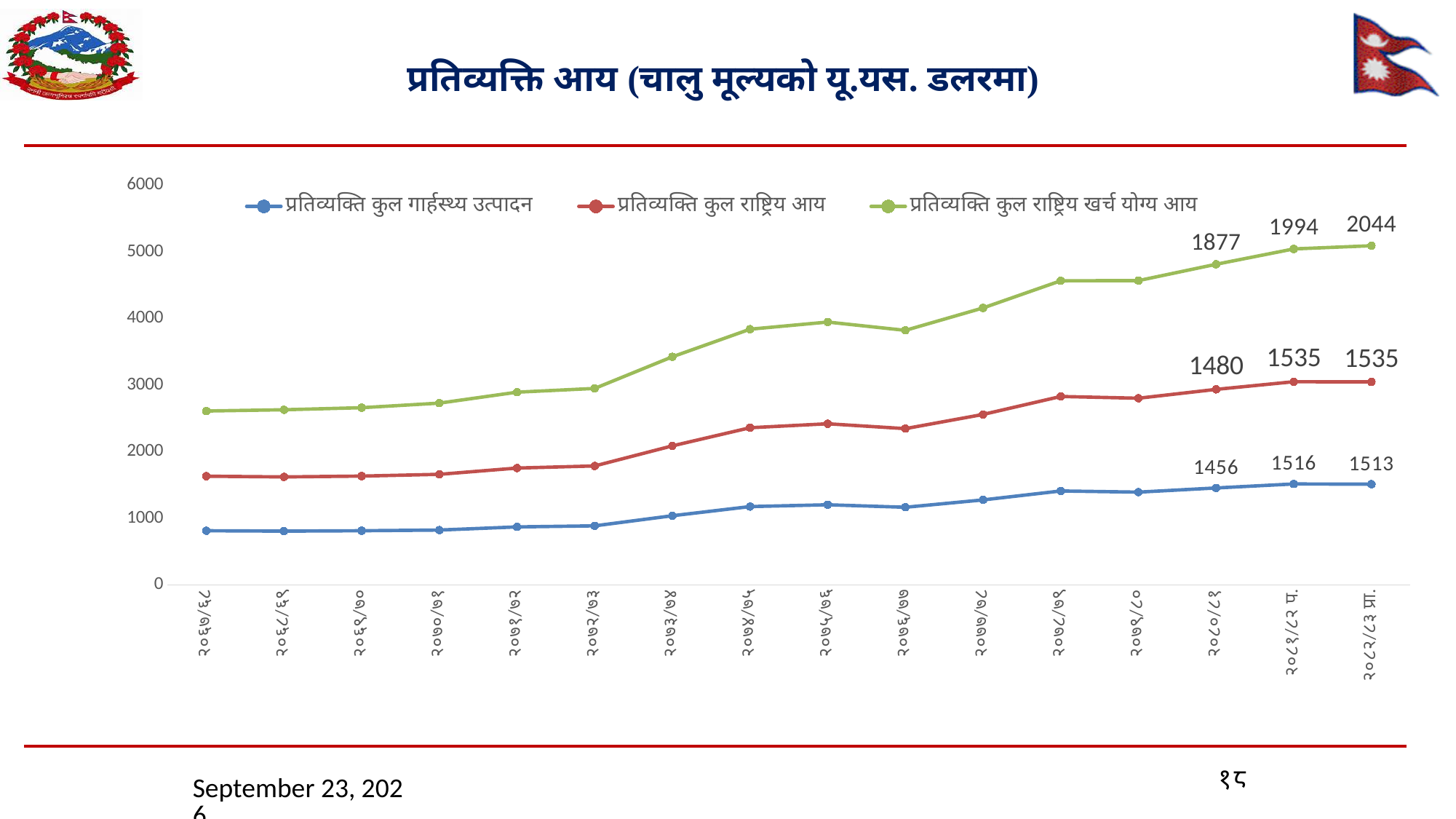
How many series does the legend list? 3 What is the labelled value of प्रतिव्यक्ति कुल गार्हस्थ्य उत्पादन for २०८१/८२ प.? 1516 What is the labelled value of प्रतिव्यक्ति कुल राष्ट्रिय आय for २०८०/८१? 1480 Which series has the highest values across the chart? प्रतिव्यक्ति कुल राष्ट्रिय खर्च योग्य आय How many fiscal years are plotted along the x axis? 16 What kind of chart is shown on the slide? line chart Is the value for प्रतिव्यक्ति कुल गार्हस्थ्य उत्पादन in २०६७/६८ greater or less than 1000? less For २०८२/८३ प्रा., what is the difference between the labelled values of प्रतिव्यक्ति कुल राष्ट्रिय आय and प्रतिव्यक्ति कुल गार्हस्थ्य उत्पादन? 22 For प्रतिव्यक्ति कुल गार्हस्थ्य उत्पादन, which year has the larger labelled value: २०८१/८२ प. or २०८२/८३ प्रा.? २०८१/८२ प. Do the values of प्रतिव्यक्ति कुल राष्ट्रिय आय generally rise or fall from २०६७/६८ to २०८२/८३ प्रा.? rise By how much does the labelled value of प्रतिव्यक्ति कुल राष्ट्रिय खर्च योग्य आय increase from २०८१/८२ प. to २०८२/८३ प्रा.? 50 What is the labelled value of प्रतिव्यक्ति कुल राष्ट्रिय खर्च योग्य आय for २०८२/८३ प्रा.? 2044